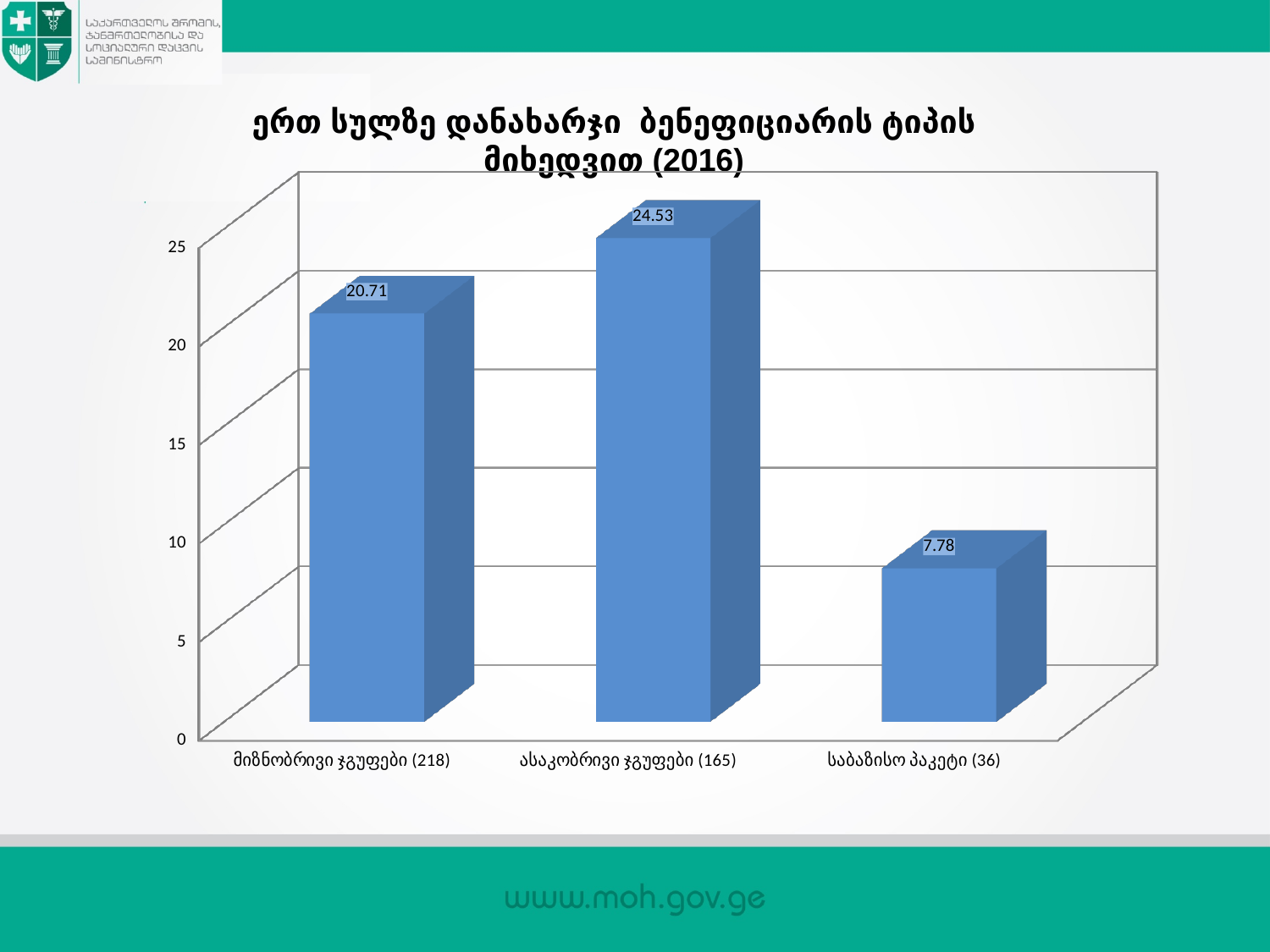
What is the difference between the values for ასაკობრივი ჯგუფები (165) and მიზნობრივი ჯგუფები (218)? 3.82 What is the value for მიზნობრივი ჯგუფები (218)? 20.71 Which category has the lowest value? საბაზისო პაკეტი (36) What is the value for საბაზისო პაკეტი (36)? 7.78 Which is larger, the value for მიზნობრივი ჯგუფები (218) or the value for საბაზისო პაკეტი (36)? მიზნობრივი ჯგუფები (218) What is the value for ასაკობრივი ჯგუფები (165)? 24.53 Which category has the highest value? ასაკობრივი ჯგუფები (165) How many categories are shown in the chart? 3 What is the title of the chart? ერთ სულზე დანახარჯი ბენეფიციარის ტიპის მიხედვით (2016) What kind of chart is shown on the slide? bar chart Is the value for საბაზისო პაკეტი (36) greater or less than 10? less What is the difference between the values for მიზნობრივი ჯგუფები (218) and საბაზისო პაკეტი (36)? 12.93